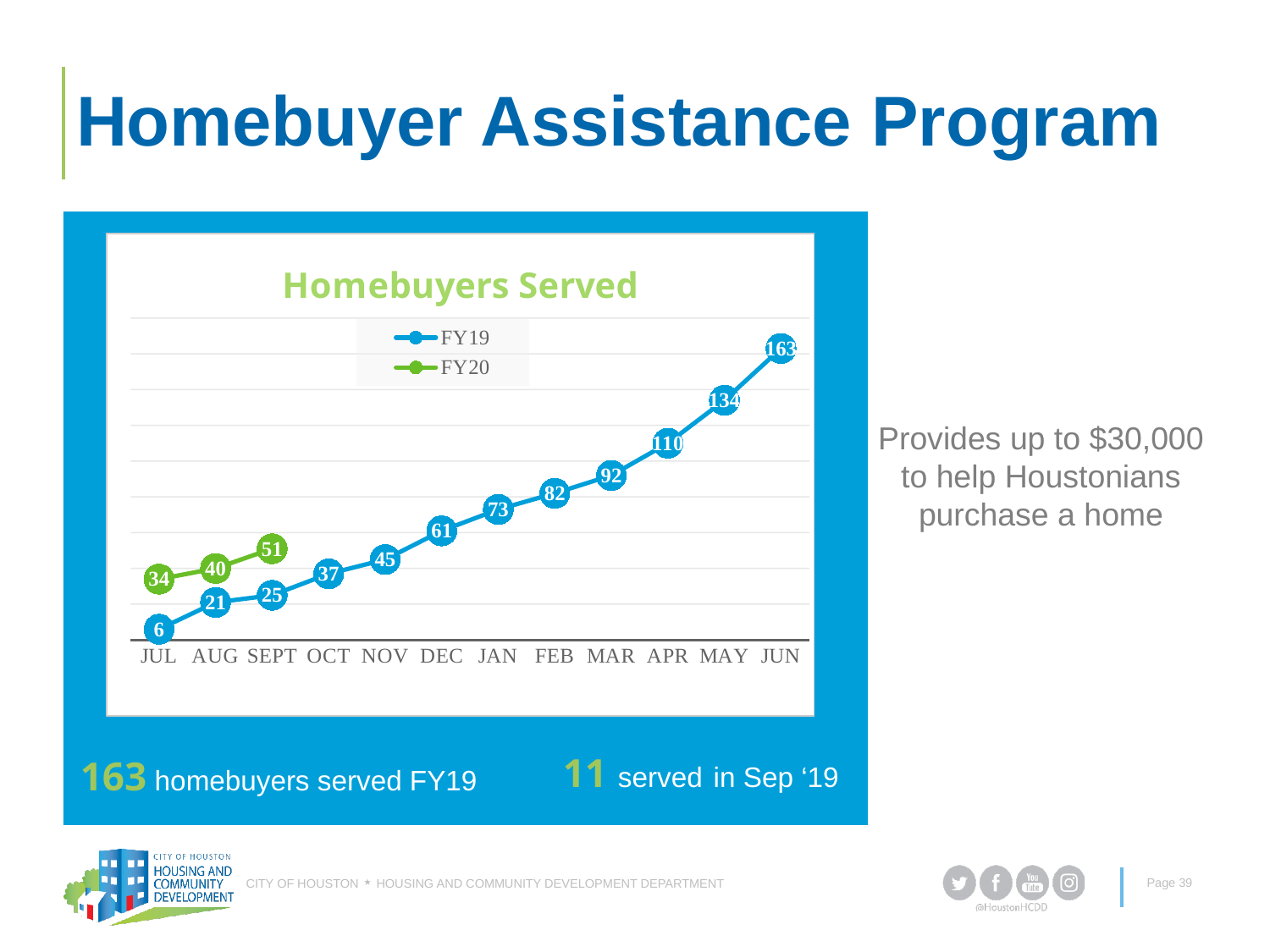
Which month has the highest FY19 value in the Homebuyers Served chart? JUN Which month has the lowest FY19 value in the Homebuyers Served chart? JUL What is the difference between the FY20 and FY19 values for SEPT in the Homebuyers Served chart? 26 What is the FY19 value for JUL in the Homebuyers Served chart? 6 What is the FY20 value for SEPT in the Homebuyers Served chart? 51 What kind of chart is the Homebuyers Served chart? line chart How many series does the legend list in the Homebuyers Served chart? 2 What is the FY20 value for AUG in the Homebuyers Served chart? 40 Which is larger in the Homebuyers Served chart: the FY19 value for AUG or the FY20 value for AUG? FY20 Do the FY19 values rise or fall from JUL to JUN in the Homebuyers Served chart? rise How many months are shown on the x axis of the Homebuyers Served chart? 12 What is the FY19 value for JUN in the Homebuyers Served chart? 163